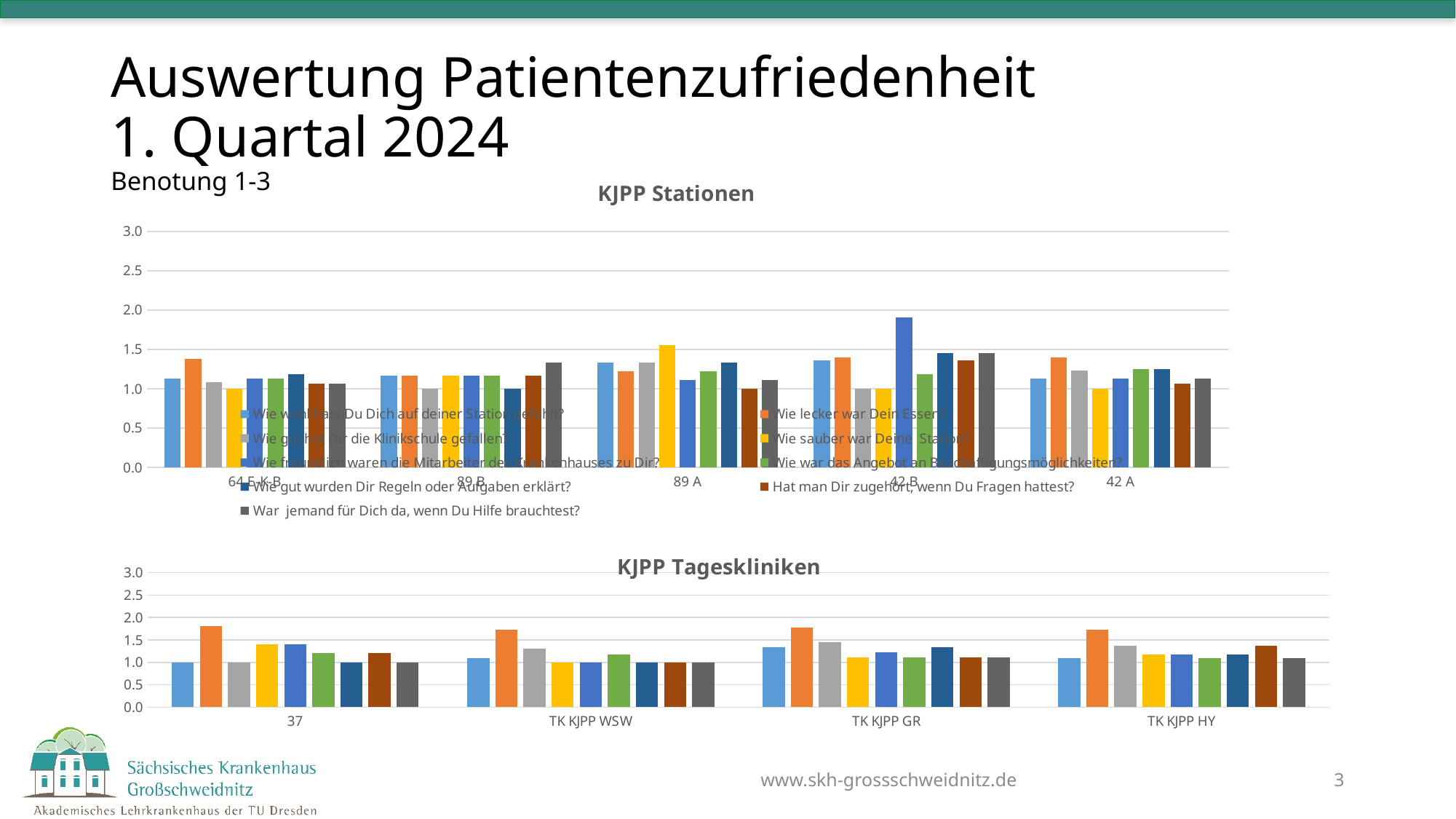
How many categories are shown on the x axis of the KJPP Tageskliniken chart? 4 How many categories are shown on the x axis of the KJPP Stationen chart? 5 What is the title of the lower chart on the slide? KJPP Tageskliniken In the KJPP Tageskliniken chart, is the value for 'Wie lecker war Dein Essen?' at TK KJPP GR greater or less than 1.5? greater How many series does the legend of the KJPP Stationen chart list? 9 In the KJPP Tageskliniken chart, which series has the highest value for category 37? Wie lecker war Dein Essen? In the KJPP Tageskliniken chart, for category 37, which is larger: 'Wie lecker war Dein Essen?' or 'Wie sauber war Deine Station?'? Wie lecker war Dein Essen? In the KJPP Tageskliniken chart, is the value for 'Wie lecker war Dein Essen?' at 37 greater or less than 1.5? greater What kind of chart is the KJPP Stationen chart? bar chart In the KJPP Stationen chart, which series has the highest value for category 42 B? Wie freundlich waren die Mitarbeiter des Krankenhauses zu Dir?